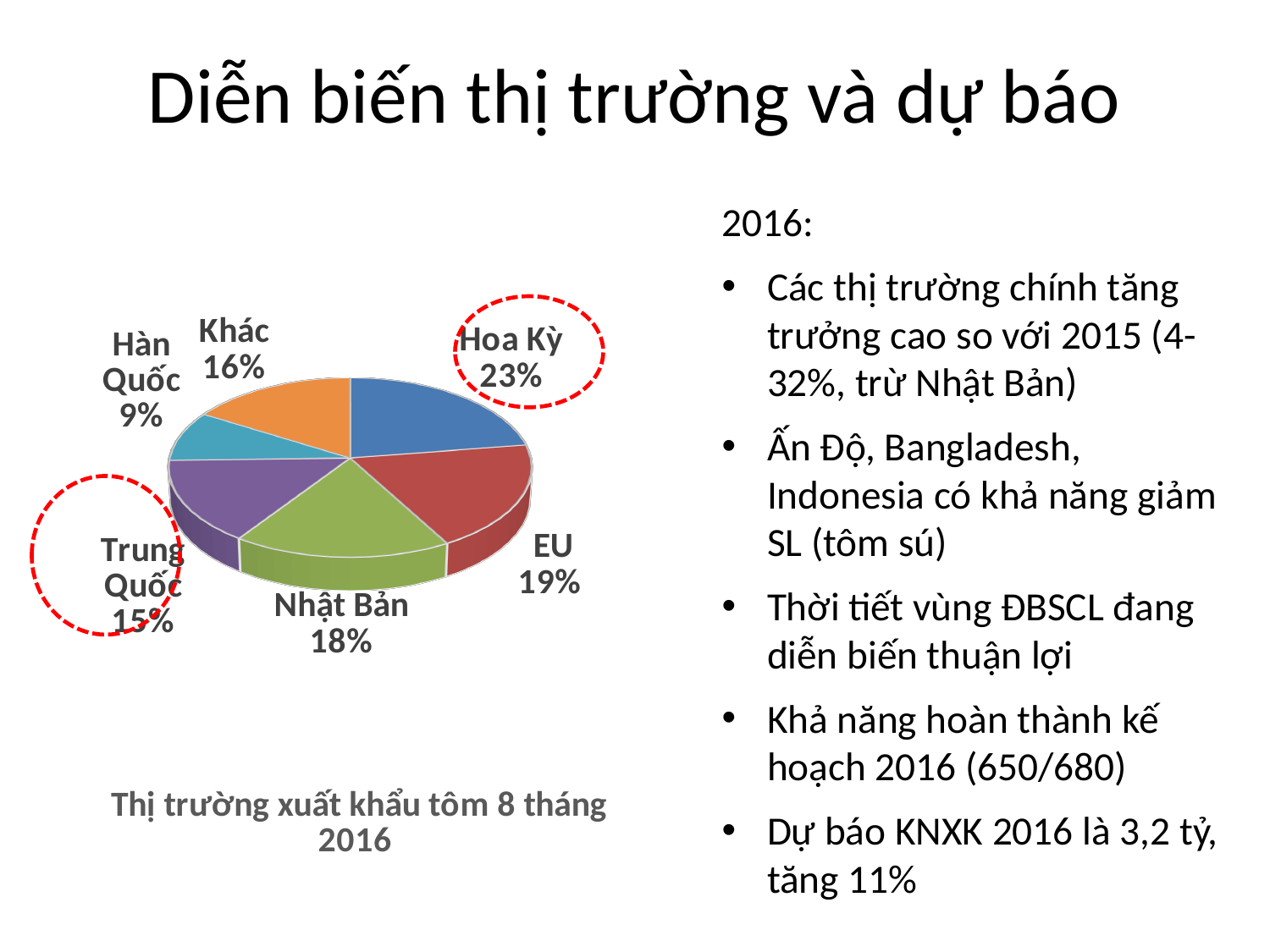
What type of chart is shown on the slide? Pie chart What is the share for EU in the pie chart? 19% What is the difference between the shares of Hoa Kỳ and Hàn Quốc? 14% What is the title of the pie chart? Thị trường xuất khẩu tôm 8 tháng 2016 What is the share for Hàn Quốc in the pie chart? 9% What is the share for Nhật Bản in the pie chart? 18% Which market has the smallest share in the pie chart? Hàn Quốc Which market has the largest share in the pie chart? Hoa Kỳ What is the share for Trung Quốc in the pie chart? 15% What is the share for Hoa Kỳ in the pie chart? 23% Which has a larger share, EU or Khác? EU How many slices does the pie chart have? 6